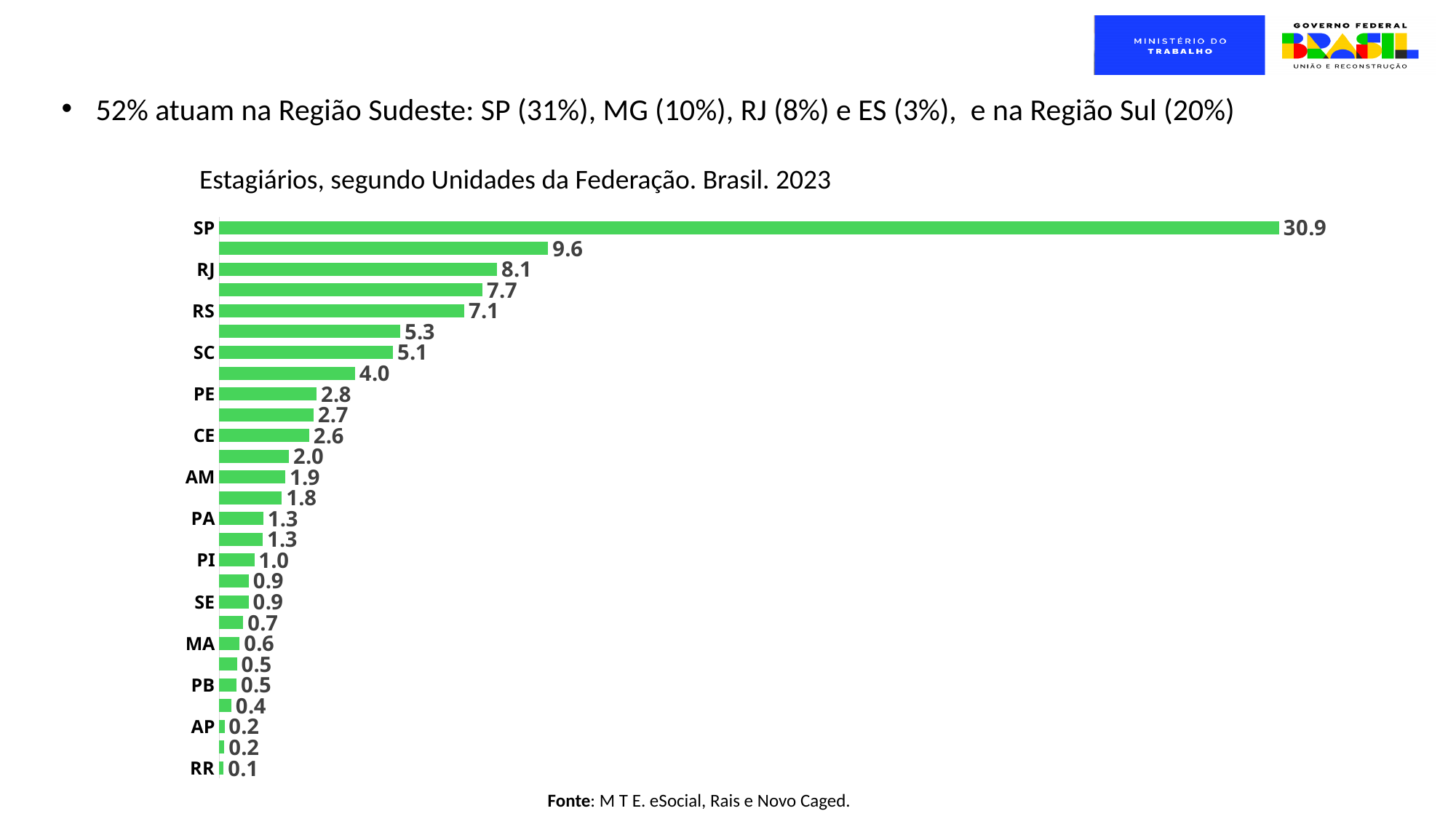
What is the value for RJ in the chart? 8.1 What is the value for SC in the chart? 5.1 What is the value for PE in the chart? 2.8 Which labelled state has the highest value in the chart? SP Which has a larger value, RS or SC? RS What is the value for AM in the chart? 1.9 What is the value for RS in the chart? 7.1 How many bars are plotted in the chart? 27 What is the difference between the values for SP and RJ? 22.8 What is the value for SP in the chart? 30.9 Which labelled state has the lowest value in the chart? RR What type of chart is shown on the slide? Bar chart